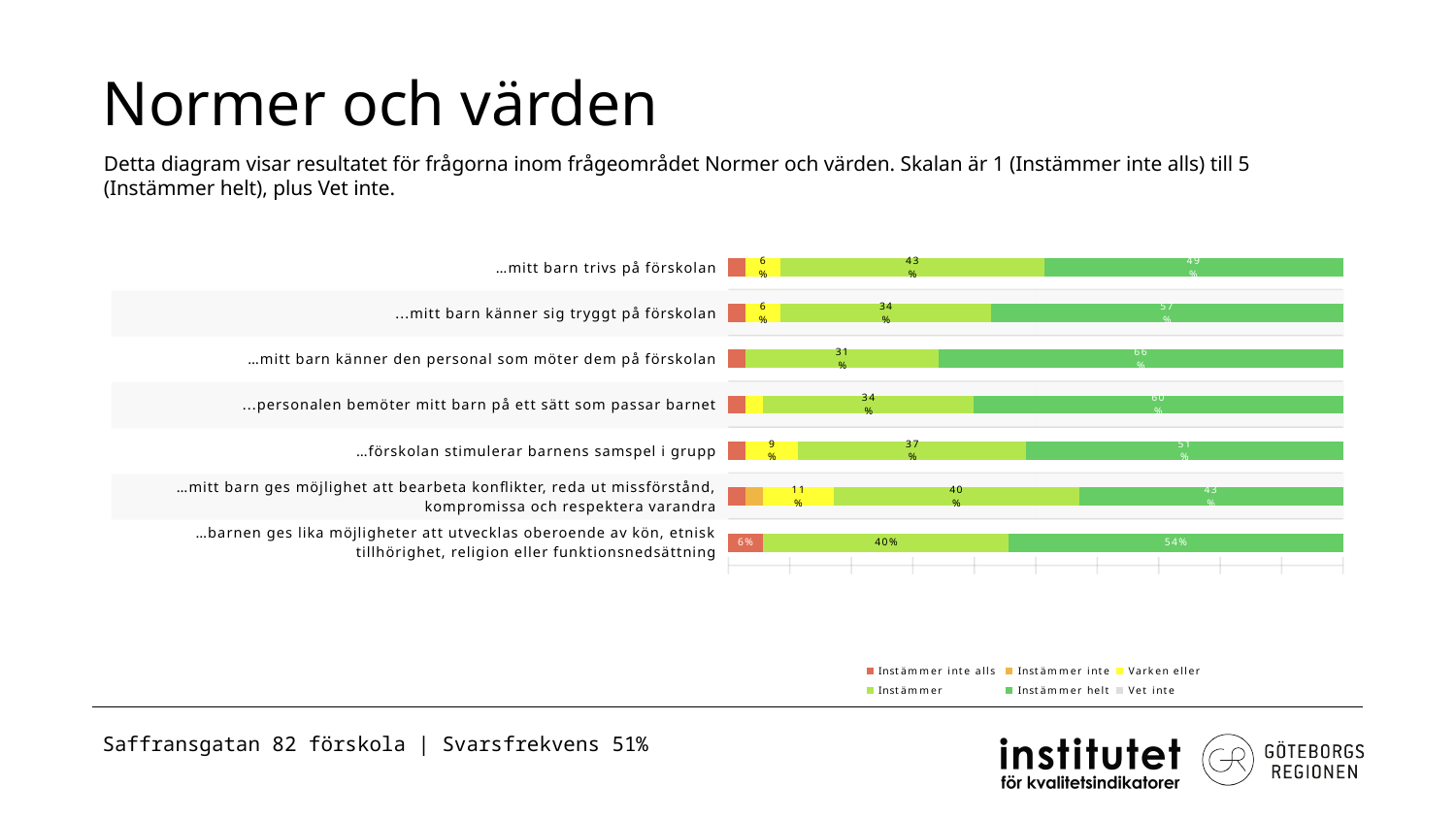
What is the Instämmer helt value for '…mitt barn känner den personal som möter dem på förskolan'? 66% How many statements (categories) are plotted in the chart? 7 For '…mitt barn känner den personal som möter dem på förskolan', how many percentage points higher is Instämmer helt than Instämmer? 35 percentage points What is the Instämmer helt value for '…barnen ges lika möjligheter att utvecklas oberoende av kön, etnisk tillhörighet, religion eller funktionsnedsättning'? 54% What is the Instämmer value for '…mitt barn trivs på förskolan'? 43% Which colour represents Instämmer helt in the legend? Dark green What is the Varken eller value for '…mitt barn ges möjlighet att bearbeta konflikter, reda ut missförstånd, kompromissa och respektera varandra'? 11% Which statement has the highest Instämmer helt share? …mitt barn känner den personal som möter dem på förskolan Which has a larger Instämmer helt share: '…mitt barn känner sig tryggt på förskolan' or '…mitt barn trivs på förskolan'? …mitt barn känner sig tryggt på förskolan What kind of chart is shown on the slide? Stacked bar chart Which statement has the lowest Instämmer helt share? …mitt barn ges möjlighet att bearbeta konflikter, reda ut missförstånd, kompromissa och respektera varandra How many series does the legend list? 6